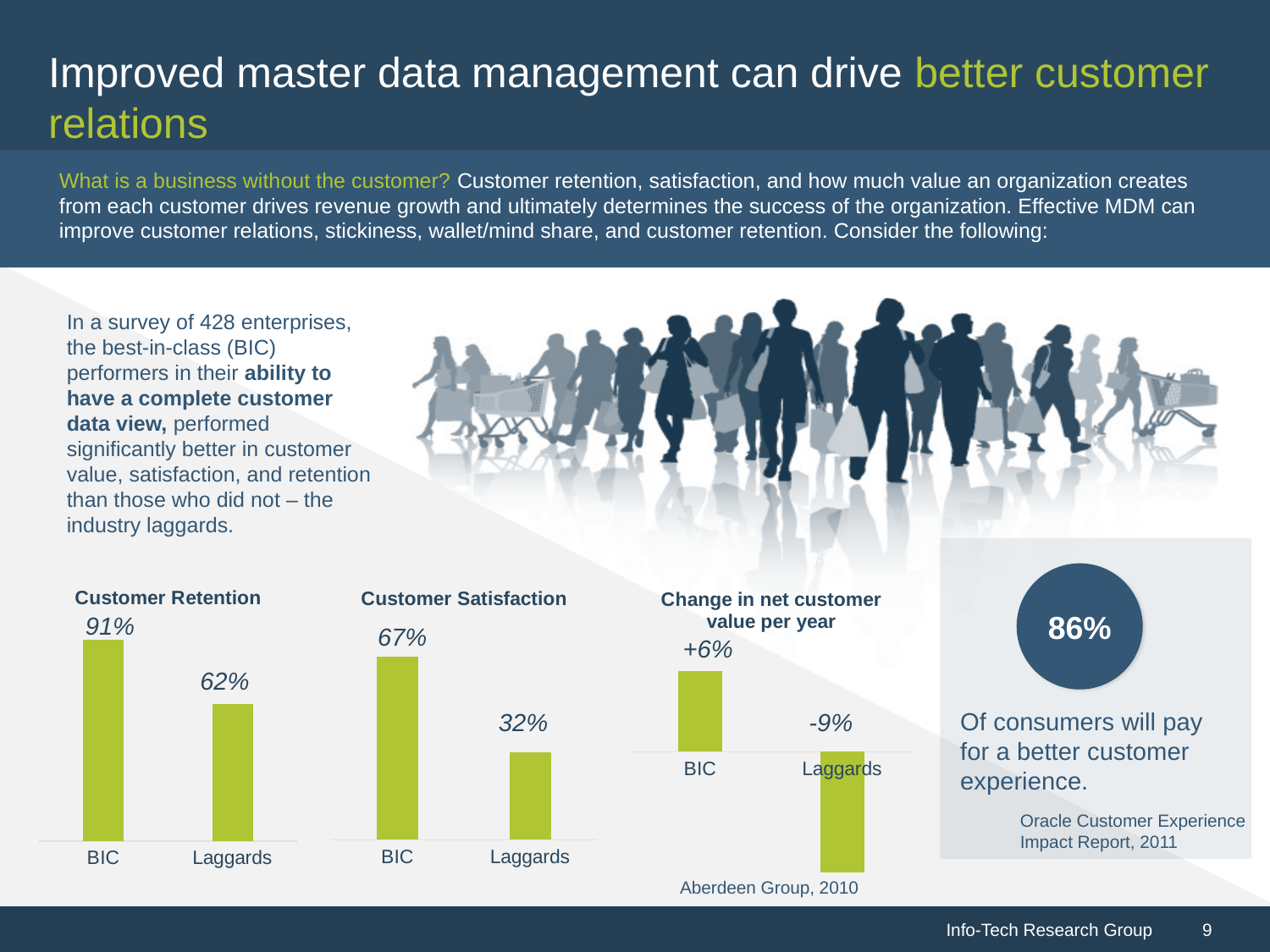
In the Customer Retention chart, which is larger, the value for BIC or the value for Laggards? BIC What is the title of the chart on the far left of the slide? Customer Retention What kind of chart is the Change in net customer value per year chart? Bar chart In the Change in net customer value per year chart, what is the value for Laggards? -9% In the Customer Satisfaction chart, which category has the highest value? BIC In the Change in net customer value per year chart, which category has the lowest value? Laggards In the Customer Retention chart, what is the value for BIC? 91% In the Customer Satisfaction chart, what is the value for Laggards? 32% In the Customer Satisfaction chart, what is the difference between the BIC and Laggards values? 35% In the Customer Retention chart, what is the difference between the BIC and Laggards values? 29% In the Customer Retention chart, what is the value for Laggards? 62% How many categories does the Customer Satisfaction chart show? 2